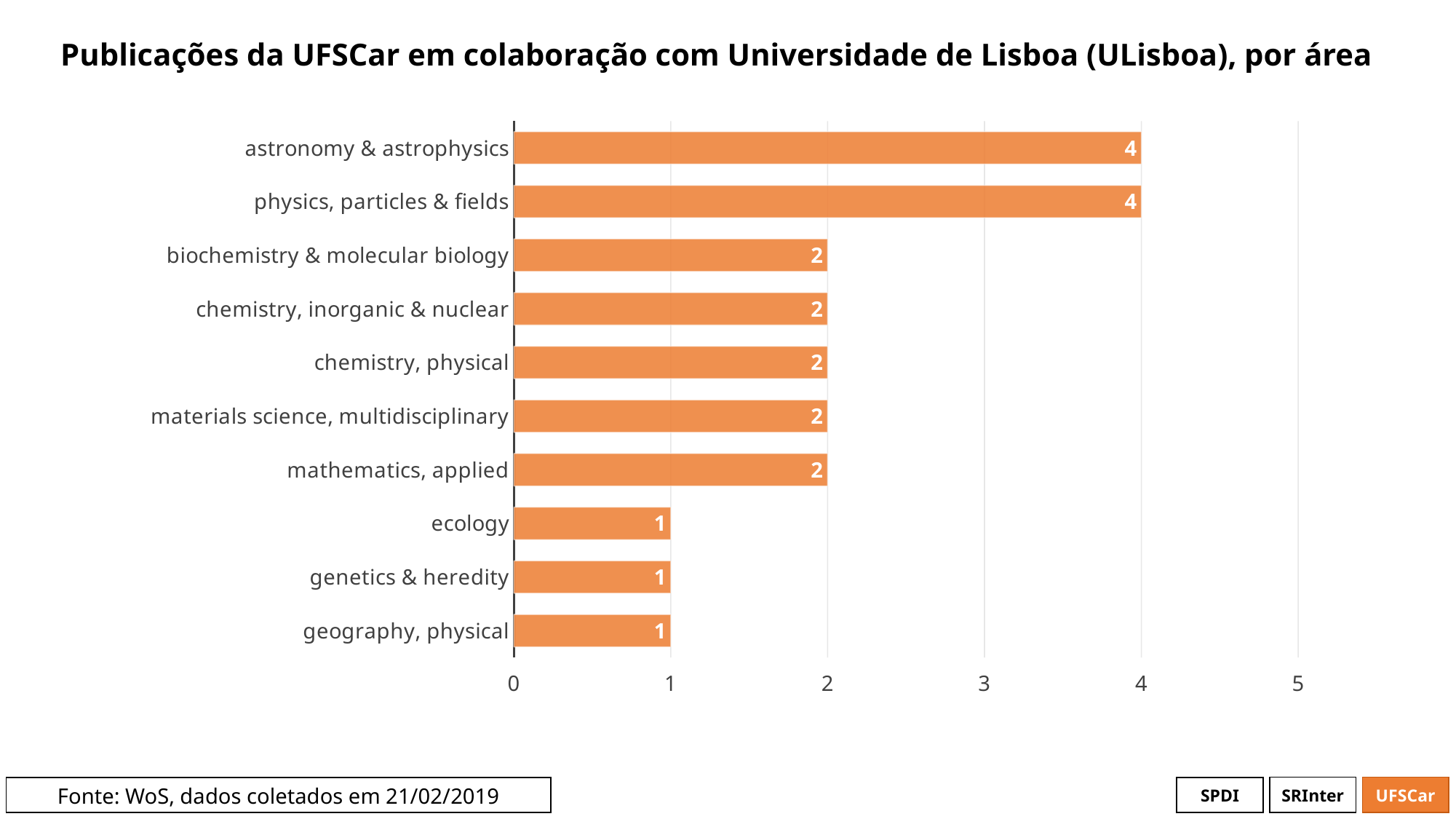
What is the value for biochemistry & molecular biology? 2 What is the title of the chart? Publicações da UFSCar em colaboração com Universidade de Lisboa (ULisboa), por área What kind of chart is shown on the slide? bar chart What is the value for ecology? 1 Is the value for materials science, multidisciplinary greater or less than 3? less What is the value for mathematics, applied? 2 What is the value for astronomy & astrophysics? 4 How many categories are shown in the chart? 10 What is the difference between the values for physics, particles & fields and genetics & heredity? 3 What colour are the bars in the chart? orange Which is larger, the value for chemistry, physical or the value for geography, physical? chemistry, physical What is the difference between the values for astronomy & astrophysics and chemistry, inorganic & nuclear? 2